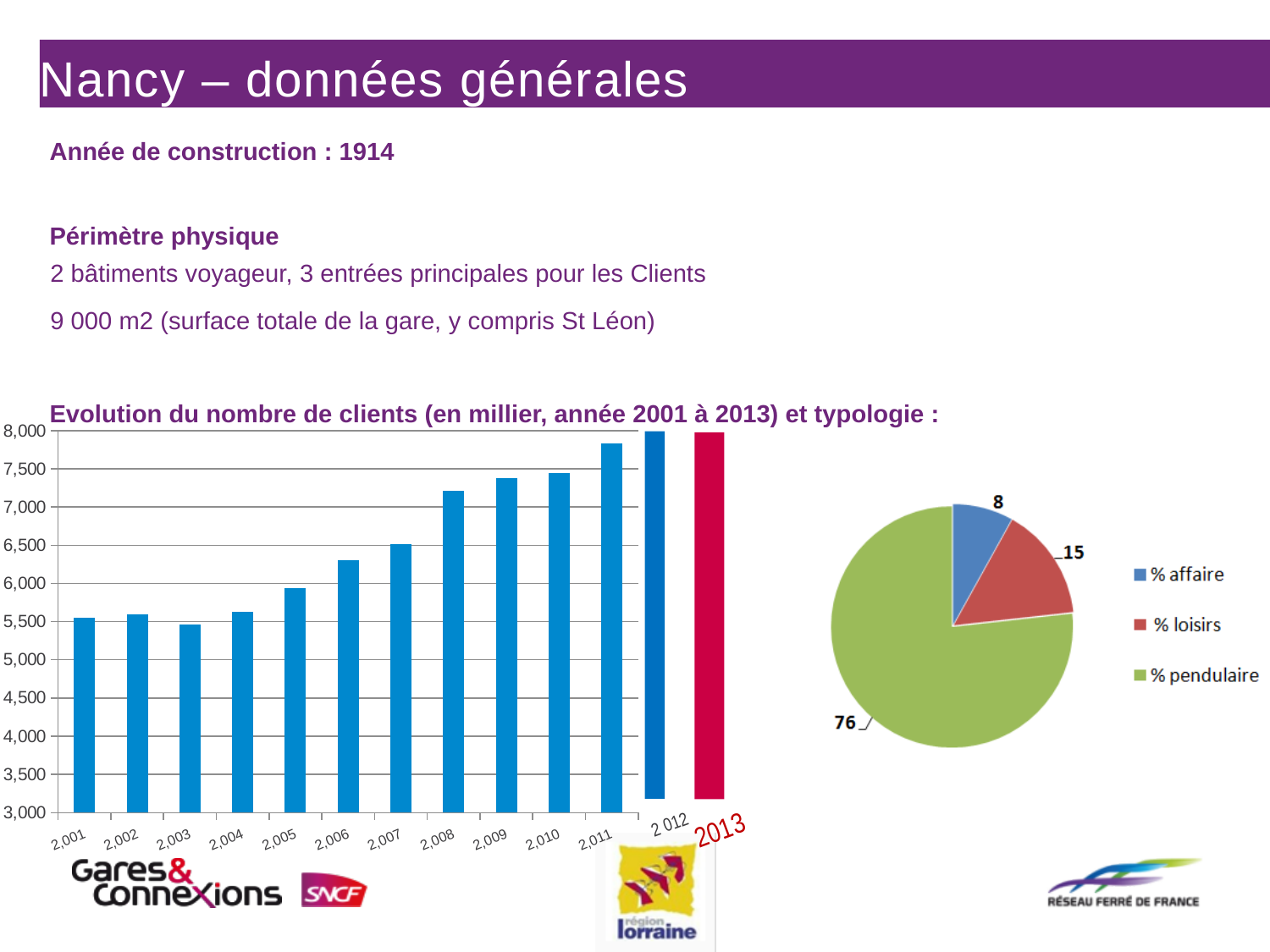
In the 'Evolution du nombre de clients' bar chart, do the values generally rise or fall from 2001 to 2013? rise In the 'Evolution du nombre de clients' bar chart, which is larger, the value for 2010 or the value for 2004? 2010 In the 'Evolution du nombre de clients' bar chart, is the value for 2001 greater or less than 5,000? greater In the 'Evolution du nombre de clients' bar chart, is the value for 2006 greater or less than 6,000? greater What kind of chart is the 'Evolution du nombre de clients' chart on the left? bar chart In the 'Evolution du nombre de clients' bar chart, is the value for 2008 greater or less than 7,000? greater In the pie chart on the right, what is the value for '% pendulaire'? 76 In the pie chart on the right, what is the difference between the values for '% pendulaire' and '% loisirs'? 61 In the pie chart on the right, which category has the smallest slice? % affaire In the 'Evolution du nombre de clients' bar chart, what colour is the bar for 2013? red How many years (bars) are shown in the 'Evolution du nombre de clients' bar chart? 13